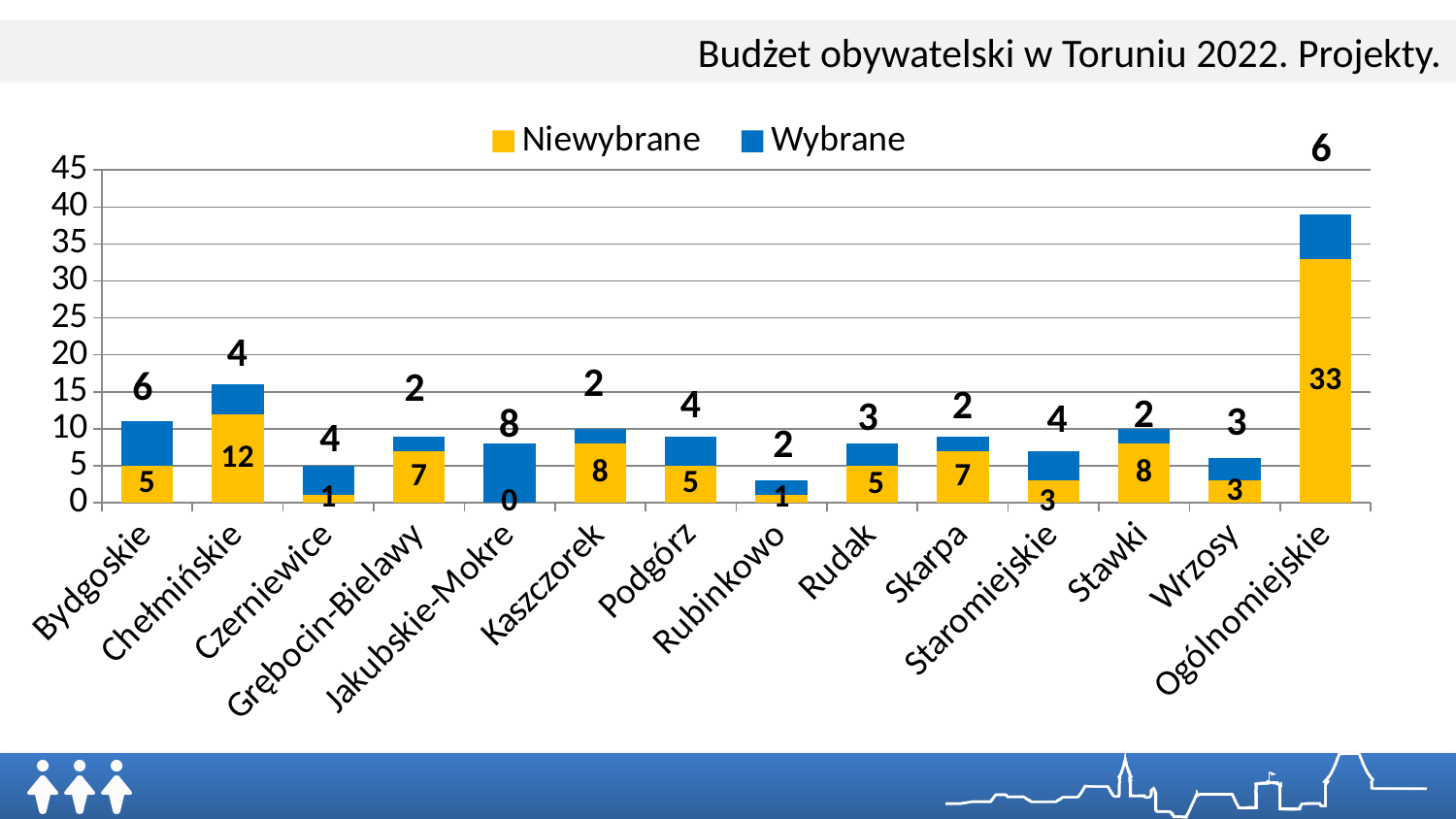
What is the difference between the Niewybrane values for Chełmińskie and Bydgoskie? 7 What is the Niewybrane value for Chełmińskie? 12 Which category has the lowest Niewybrane value? Jakubskie-Mokre What is the total of the stacked bar for Chełmińskie? 16 Which category has the highest Niewybrane value? Ogólnomiejskie What is the total of the stacked bar for Ogólnomiejskie? 39 What type of chart is shown on the slide? Stacked bar chart What is the Wybrane value for Jakubskie-Mokre? 8 What is the Niewybrane value for Ogólnomiejskie? 33 How many series does the legend list? 2 Which is larger, the Wybrane value for Bydgoskie or the Wybrane value for Rudak? Bydgoskie How many categories are shown on the x axis? 14